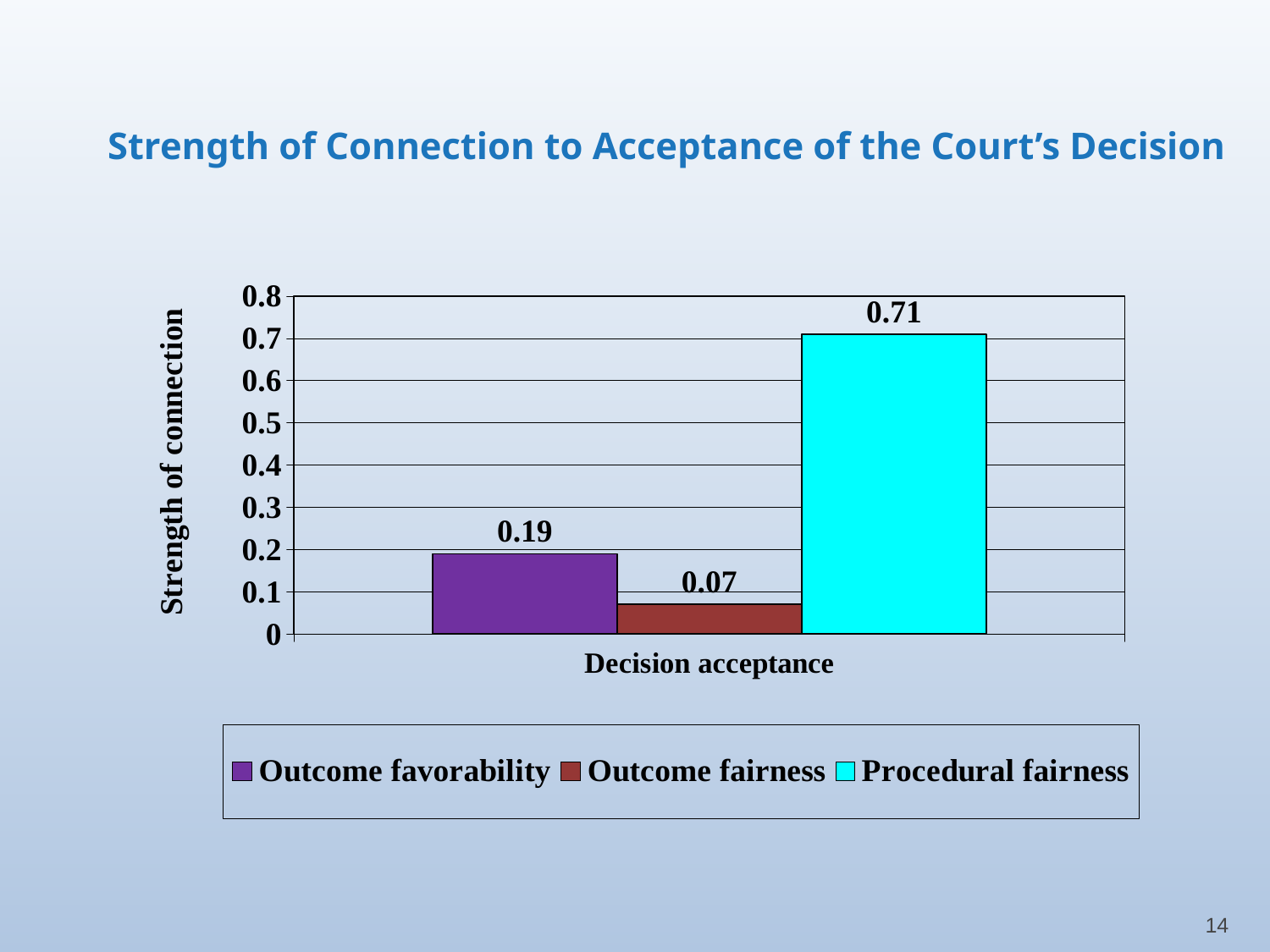
What is the strength of connection for Outcome favorability? 0.19 What is the strength of connection for Outcome fairness? 0.07 How many series does the legend list? 3 Which series has the lowest strength of connection to decision acceptance? Outcome fairness What is the strength of connection for Procedural fairness? 0.71 Which series has the highest strength of connection to decision acceptance? Procedural fairness Which is larger, the value for Outcome favorability or the value for Outcome fairness? Outcome favorability What is the difference between the values for Procedural fairness and Outcome favorability? 0.52 Is the value for Procedural fairness greater or less than 0.5? greater What kind of chart is shown on the slide? Bar chart What is the difference between the values for Outcome favorability and Outcome fairness? 0.12 What is the label on the vertical axis of the chart? Strength of connection